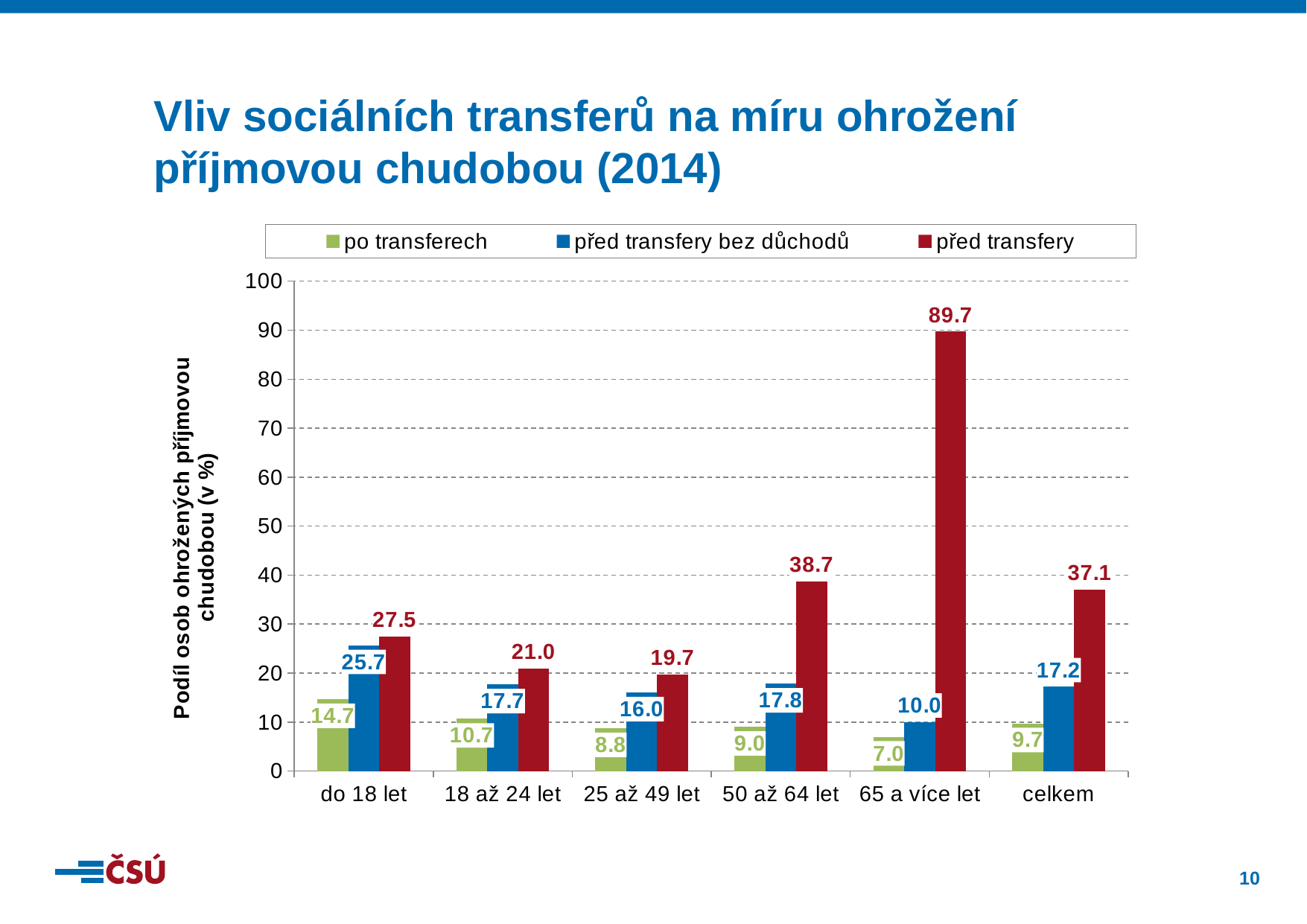
How many series does the legend list? 3 What is the value of 'po transferech' for 'do 18 let'? 14.7 What is the difference between 'před transfery' and 'po transferech' for '65 a více let'? 82.7 Is the value of 'před transfery' for 'celkem' greater or less than 30? greater What is the value of 'před transfery bez důchodů' for 'celkem'? 17.2 How many age categories are shown on the x axis? 6 What colour represents the 'po transferech' series? green Which category has the lowest value for 'po transferech'? 65 a více let What type of chart is shown on the slide? bar chart What is the value of 'před transfery' for '65 a více let'? 89.7 Which category has the highest value for 'před transfery'? 65 a více let Which is larger for '50 až 64 let': 'před transfery bez důchodů' or 'před transfery'? před transfery